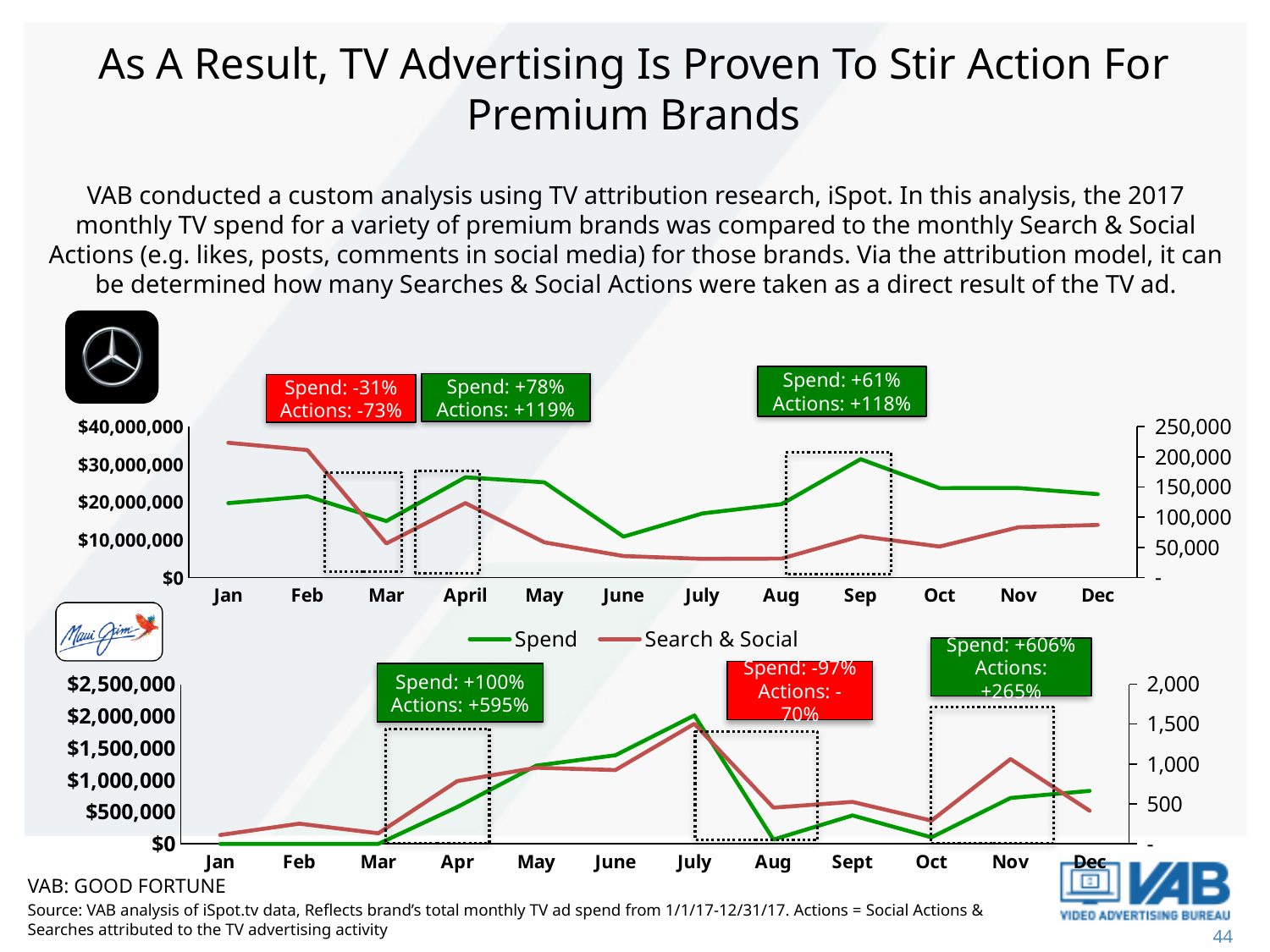
In the top chart (Mercedes-Benz), which month has the highest Spend? Sep In the top chart (Mercedes-Benz), which month has the lowest Spend? June How many months are plotted along the x axis of the bottom chart (Maui Jim)? 12 What are the two series named in the legend? Spend and Search & Social In the bottom chart (Maui Jim), which month has the highest Spend? July What kind of chart is the top chart (Mercedes-Benz)? Line chart In the bottom chart (Maui Jim), is the Spend for Aug greater or less than $500,000? less In the top chart (Mercedes-Benz), what does the annotation box above Sep say? Spend: +61% Actions: +118% In the top chart (Mercedes-Benz), is the Search & Social value for Jan greater or less than 200,000? greater In the top chart (Mercedes-Benz), which month has the highest Search & Social value? Jan How many series does the legend list for the charts? 2 In the top chart (Mercedes-Benz), is the Spend for June greater or less than $20,000,000? less